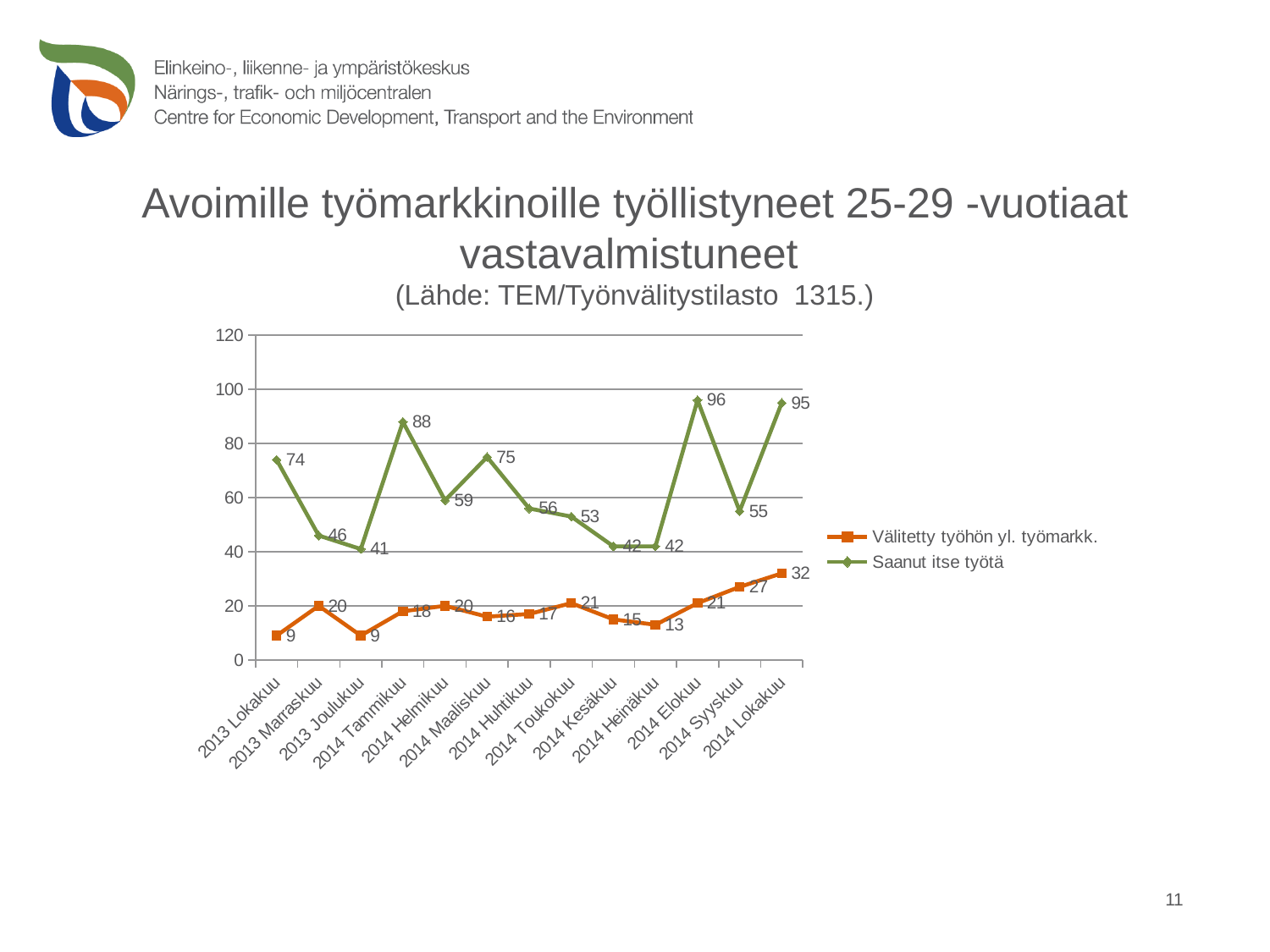
Which is larger in 2014 Maaliskuu: 'Saanut itse työtä' or 'Välitetty työhön yl. työmarkk.'? Saanut itse työtä In which month is 'Saanut itse työtä' at its lowest value? 2013 Joulukuu Is the value of 'Saanut itse työtä' for 2014 Helmikuu greater or less than 80? less What is the value of 'Välitetty työhön yl. työmarkk.' for 2014 Syyskuu? 27 What type of chart is shown on the slide? line chart In which month does 'Saanut itse työtä' reach its highest value? 2014 Elokuu How many months are plotted along the x axis? 13 Does 'Välitetty työhön yl. työmarkk.' rise or fall from 2014 Heinäkuu to 2014 Lokakuu? rise In which month does 'Välitetty työhön yl. työmarkk.' reach its highest value? 2014 Lokakuu How many series does the legend list? 2 What is the value of 'Saanut itse työtä' for 2014 Tammikuu? 88 What is the difference between 'Saanut itse työtä' and 'Välitetty työhön yl. työmarkk.' in 2014 Lokakuu? 63